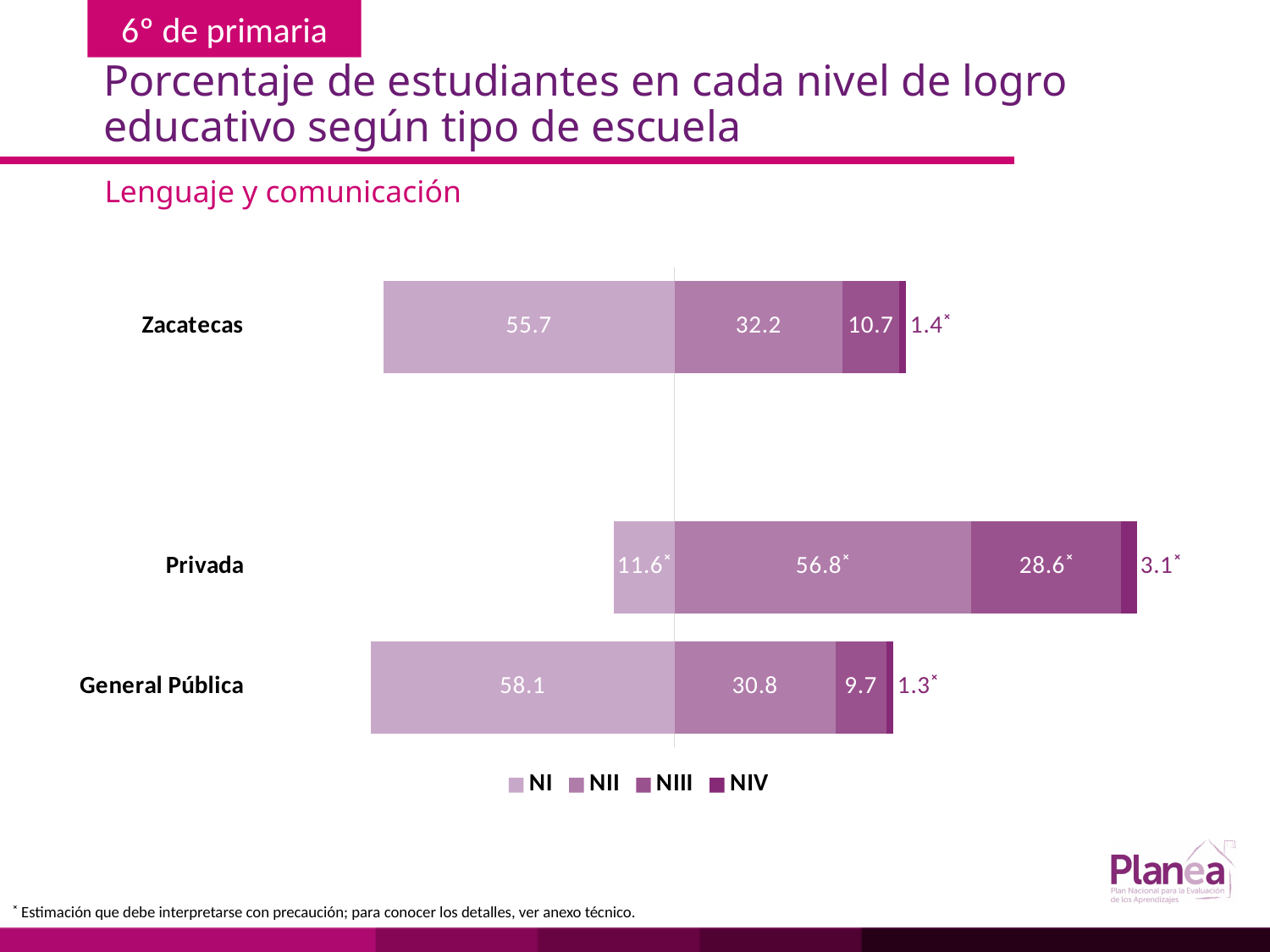
What is the NII value for General Pública? 30.8 How many series does the legend list? 4 What type of chart is shown on the slide? Stacked bar chart What percentage of Zacatecas students are at level NI? 55.7 Which school type has the highest NI value? General Pública How many categories (school types) are shown in the chart? 3 Which is larger, the NIII value for Zacatecas or for General Pública? Zacatecas What is the NIII value for Privada schools? 28.6 What is the difference between the NI values of General Pública and Zacatecas? 2.4 What is the NIV value for Zacatecas? 1.4 What is the total of the stacked bar for Zacatecas? 100.0 Which category has the lowest NI value? Privada